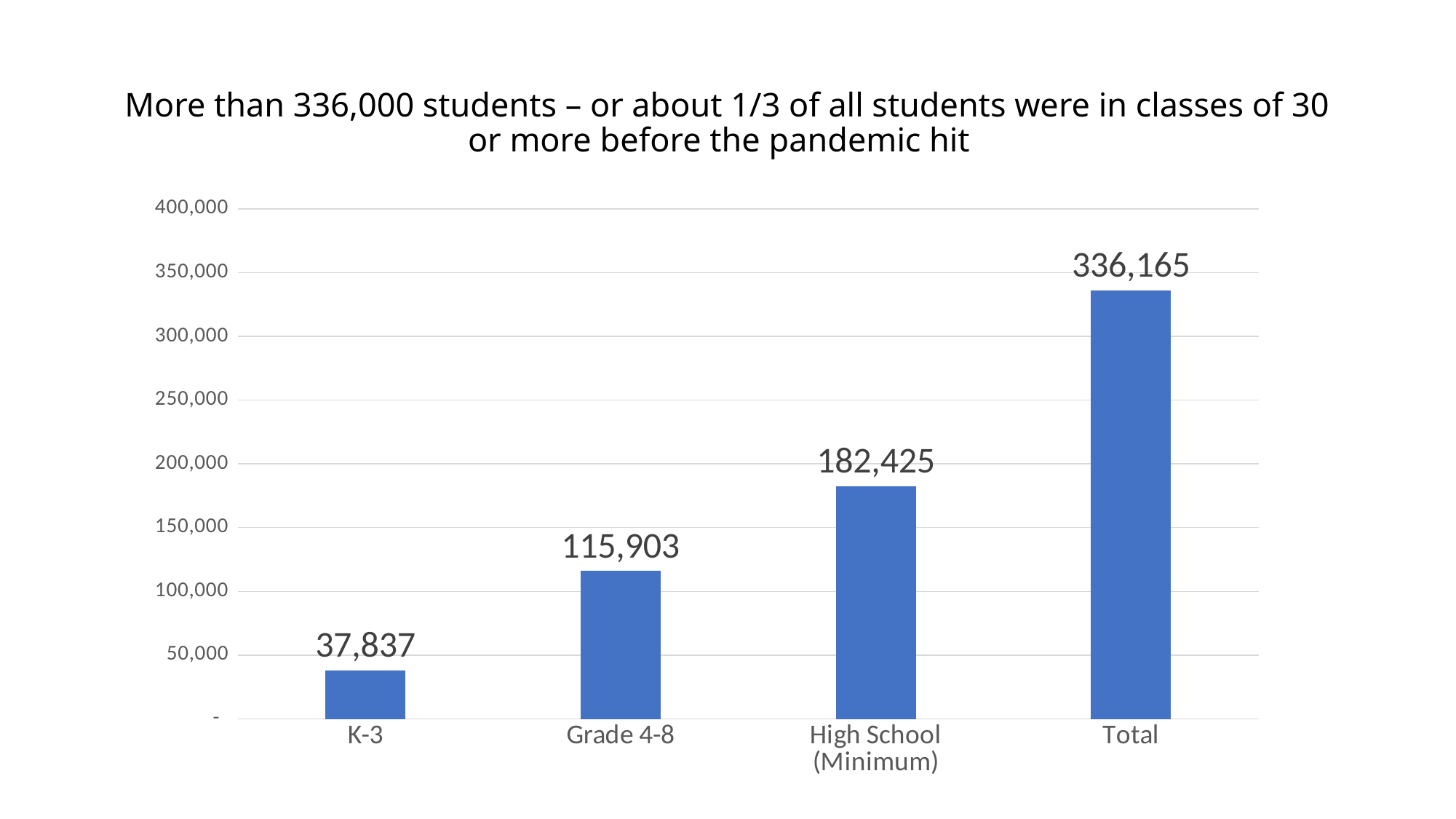
What is the difference between the values for High School (Minimum) and Grade 4-8? 66,522 Do the values rise or fall from left to right along the x axis? Rise What is the value for K-3? 37,837 What is the value for High School (Minimum)? 182,425 What is the value for Total? 336,165 Which category has the highest value? Total How many categories are shown on the x axis? 4 What is the difference between the values for Grade 4-8 and K-3? 78,066 Which is larger, the value for Grade 4-8 or the value for High School (Minimum)? High School (Minimum) What kind of chart is shown on the slide? Bar chart What is the value for Grade 4-8? 115,903 Which category has the lowest value? K-3